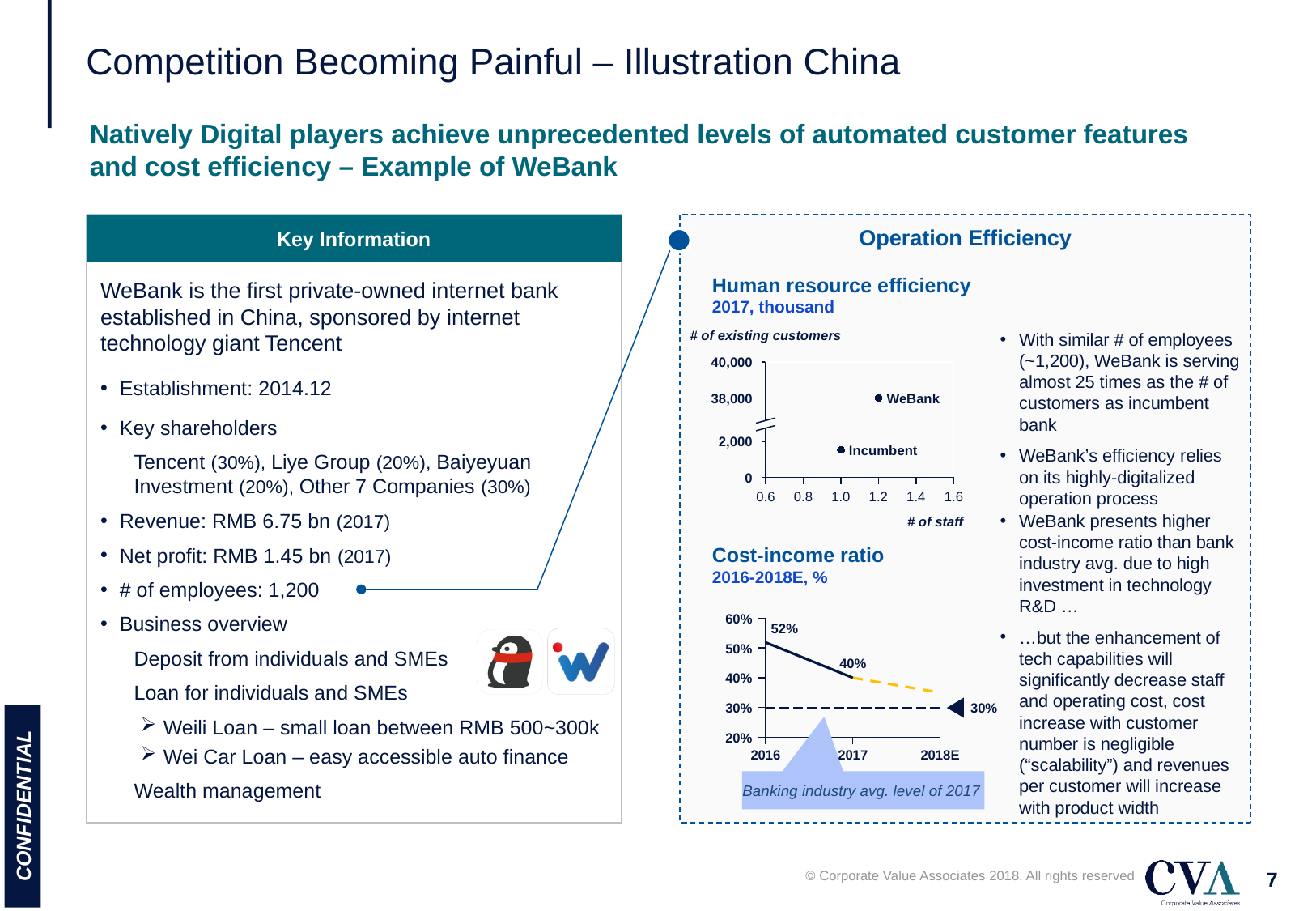
In the Cost-income ratio chart, does the cost-income ratio rise or fall from 2016 to 2018E? fall In the Cost-income ratio chart, by how many percentage points did the cost-income ratio fall from 2016 to 2017? 12 percentage points In the Cost-income ratio chart, what is WeBank's cost-income ratio in 2016? 52% In the Human resource efficiency chart, how many data points are plotted? 2 In the Human resource efficiency chart, is the number of existing customers for Incumbent greater or less than 38,000? less In the Human resource efficiency chart, is the number of existing customers for WeBank greater or less than 2,000? greater In the Cost-income ratio chart, which year has the higher cost-income ratio, 2016 or 2017? 2016 What is the unit stated under the Human resource efficiency chart title? 2017, thousand In the Cost-income ratio chart, what is the banking industry average level of 2017? 30% In the Cost-income ratio chart, how many years are shown on the x axis? 3 In the Human resource efficiency chart, which has more existing customers, WeBank or Incumbent? WeBank In the Cost-income ratio chart, what is WeBank's cost-income ratio in 2017? 40%